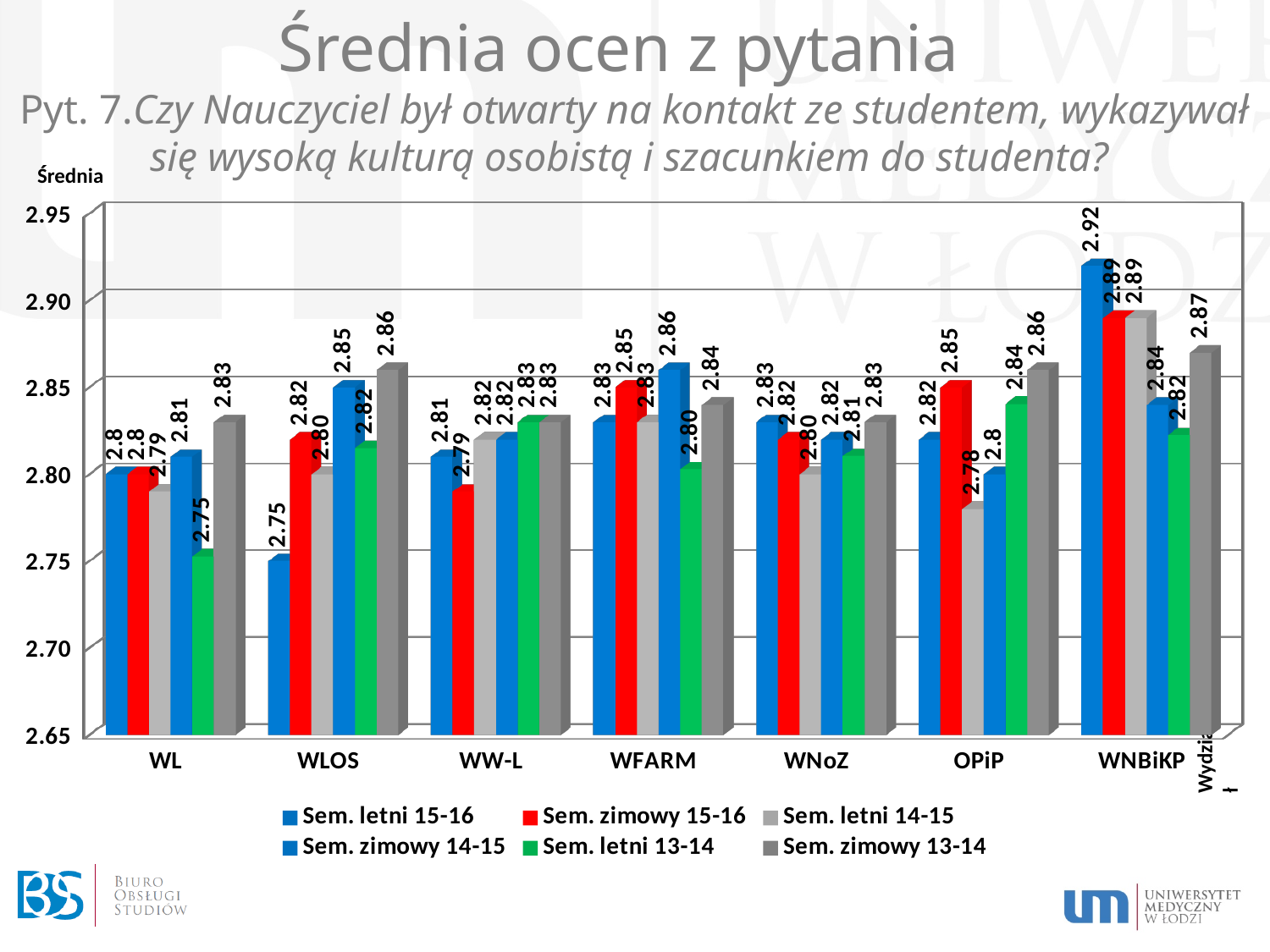
What is the value for Sem. zimowy 15-16 for WNBiKP? 2.89 Which category has the highest bar in the chart? WNBiKP What is the label on the vertical axis of the chart? Średnia Is the value for Sem. letni 13-14 for WL greater or less than 2.80? less Which is larger for Sem. zimowy 15-16: WLOS or WW-L? WLOS What is the value for Sem. letni 14-15 for OPiP? 2.78 What is the value for Sem. zimowy 13-14 for OPiP? 2.86 What kind of chart is shown on the slide? bar chart What is the value for Sem. letni 13-14 for WL? 2.75 What is the difference between Sem. zimowy 13-14 and Sem. letni 13-14 for WNBiKP? 0.05 How many series does the legend list? 6 How many categories (faculties) are shown on the x axis? 7